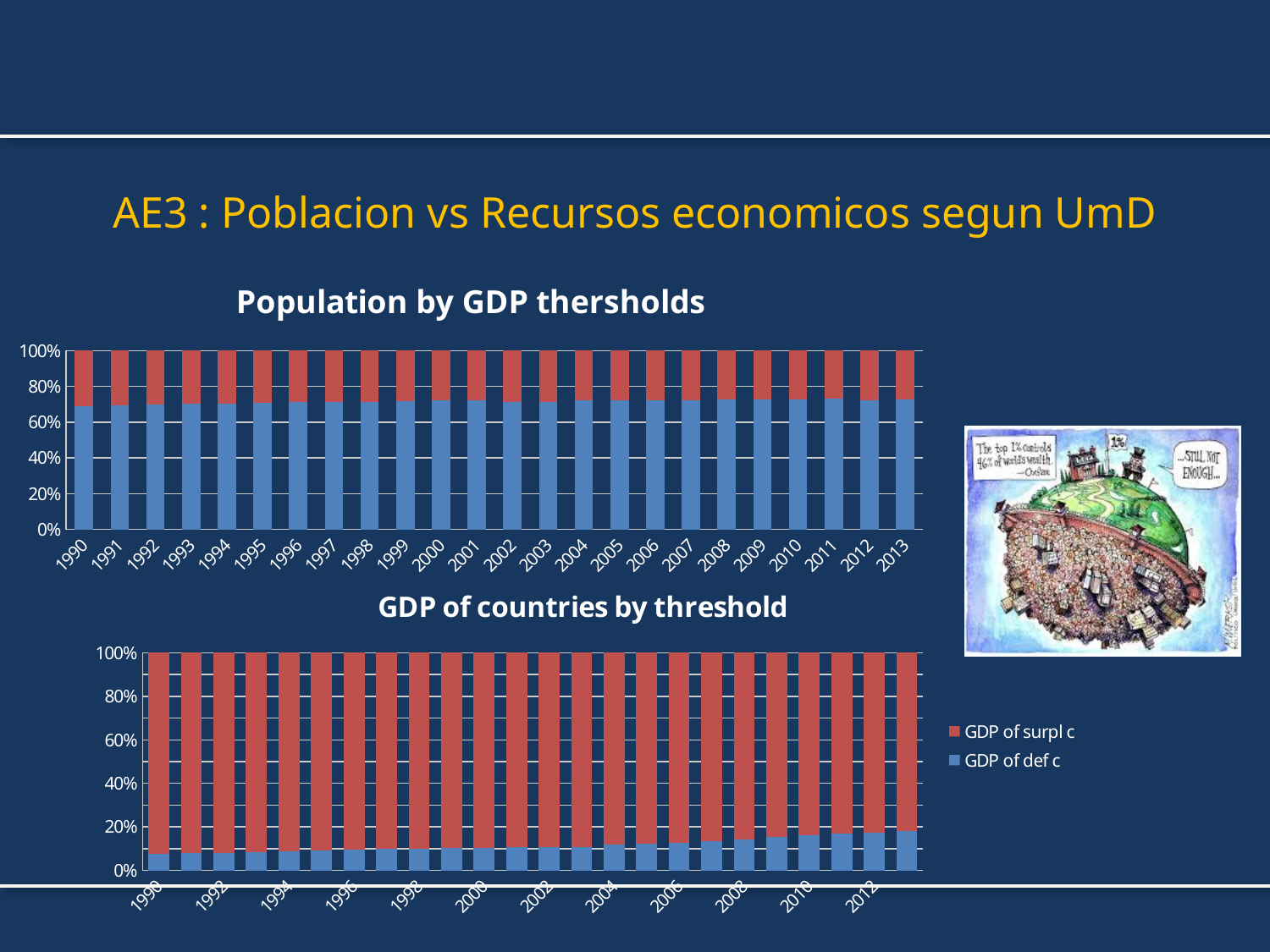
In the 'Population by GDP thersholds' chart, is the blue share for 1990 greater or less than 60%? greater In the 'GDP of countries by threshold' chart, is the red (GDP of surpl c) share for 1990 greater or less than 80%? greater In the 'Population by GDP thersholds' chart, what is the first year shown on the x axis? 1990 In the 'Population by GDP thersholds' chart, is the blue share for 2013 greater or less than 80%? less How many series does the legend next to the 'GDP of countries by threshold' chart list? 2 In the 'GDP of countries by threshold' chart, does the blue (GDP of def c) share rise or fall from 1990 to 2012? rise What kind of chart is the 'Population by GDP thersholds' chart? stacked bar chart In the 'Population by GDP thersholds' chart, what is the last year shown on the x axis? 2013 What kind of chart is the 'GDP of countries by threshold' chart? stacked bar chart In the 'Population by GDP thersholds' chart, how many years are shown on the x axis? 24